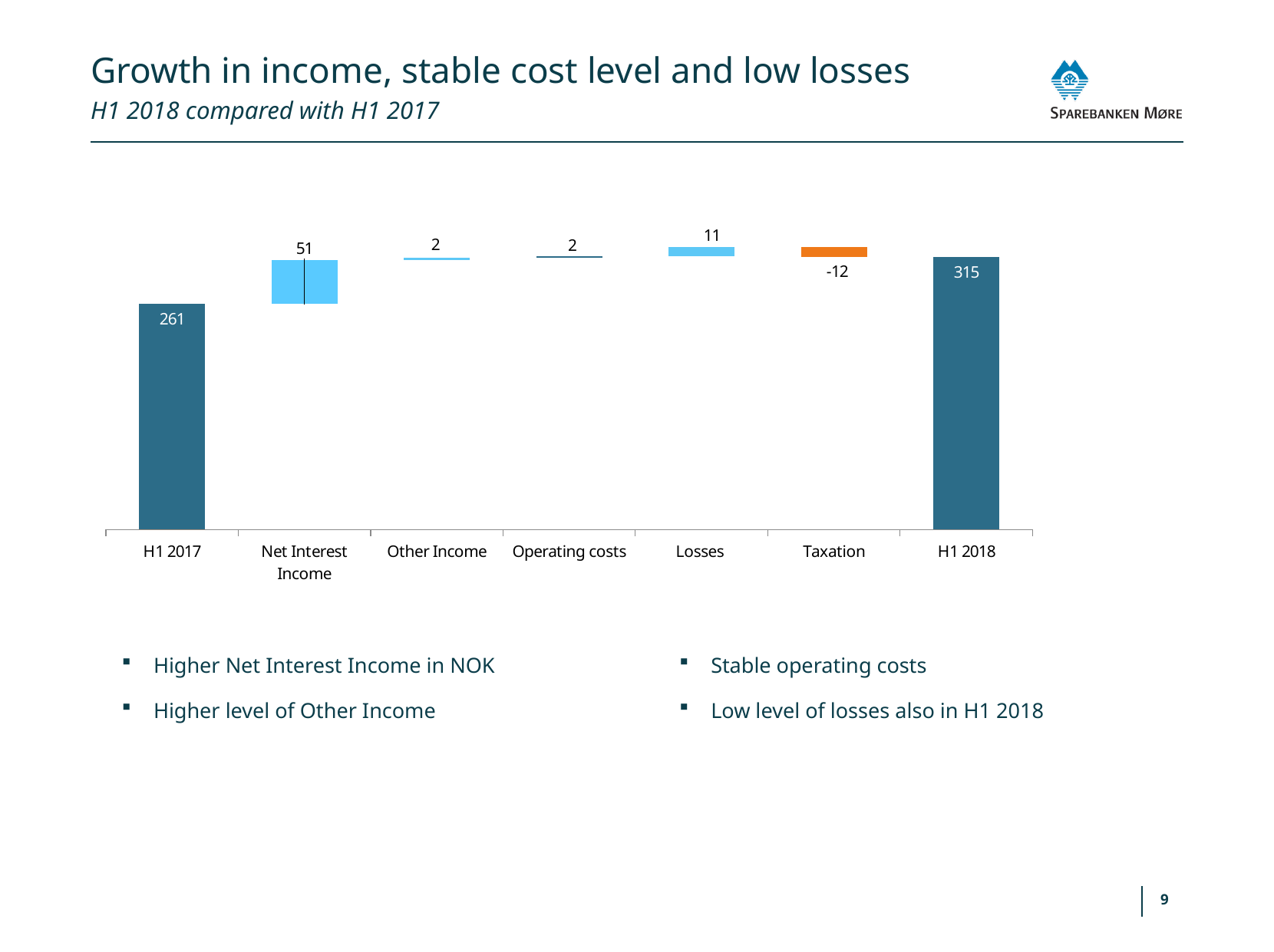
What is the value shown for H1 2017? 261 Which category has the lowest value in the chart? Taxation What colour is the Taxation bar in the chart? Orange What is the value shown for Losses? 11 Which category has the highest value in the chart? H1 2018 What is the difference between the H1 2018 value and the H1 2017 value? 54 What is the value shown for Taxation? -12 Which is larger, the value for Net Interest Income or the value for Losses? Net Interest Income How many categories are shown on the x axis of the chart? 7 What is the value shown for Net Interest Income? 51 What is the value shown for Operating costs? 2 What is the value shown for H1 2018? 315